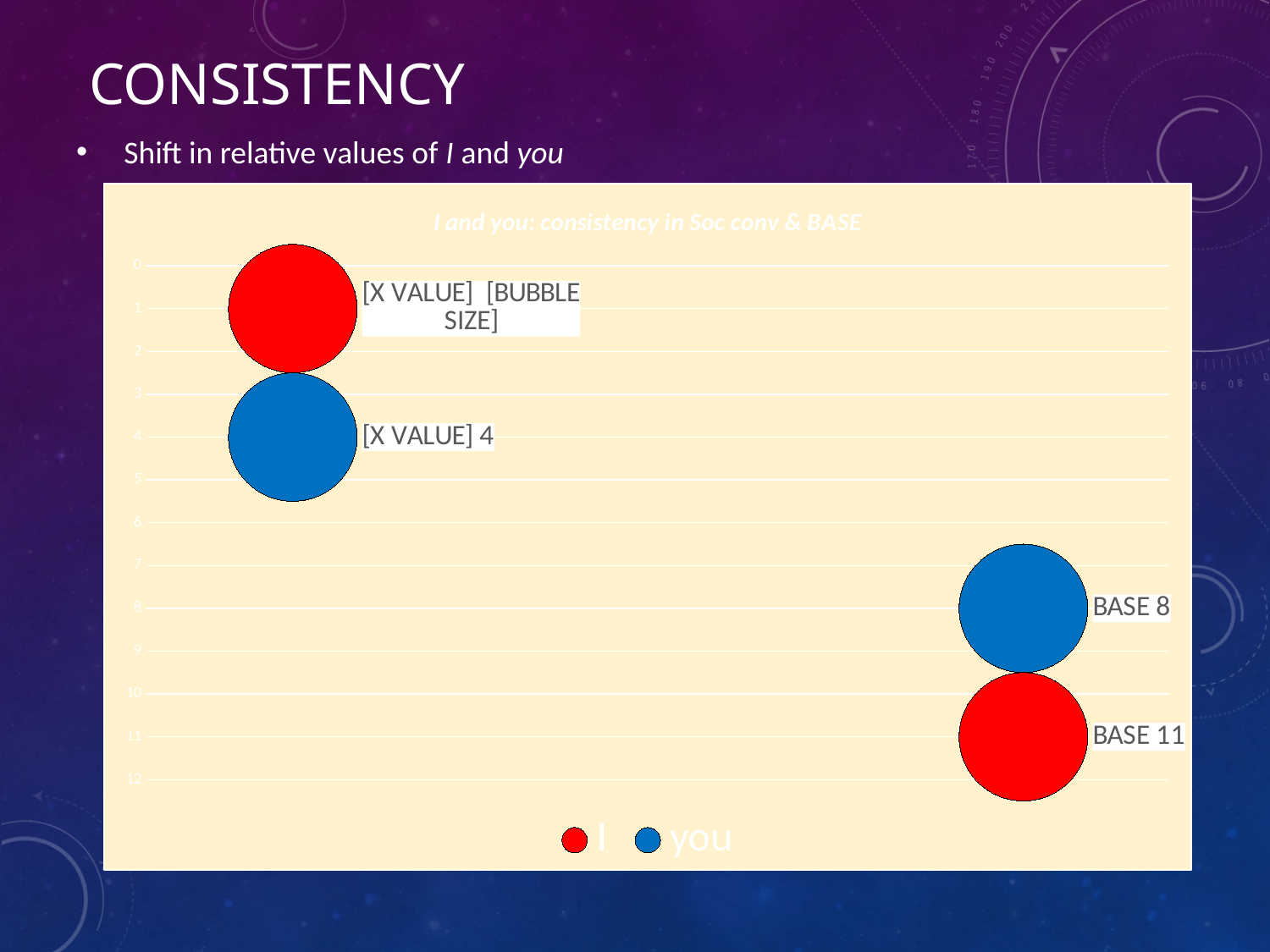
How many bubbles are plotted on the chart? 4 What is the title of the chart? I and you: consistency in Soc conv & BASE Which series is shown in red in the legend? I Is the red 'I' bubble on the left side of the chart positioned at a y-axis value greater or less than 2? less How many series does the legend list? 2 At BASE, which series has the larger labelled value, I or you? I What number is shown in the data label of the red 'I' bubble at BASE? 11 What number is shown in the data label of the blue 'you' bubble on the left side of the chart? 4 What is the difference between the labelled values of I (11) and you (8) at BASE? 3 Is the red 'I' bubble at BASE positioned at a y-axis value greater or less than 10? greater What kind of chart is shown on the slide? bubble chart What number is shown in the data label of the blue 'you' bubble at BASE? 8